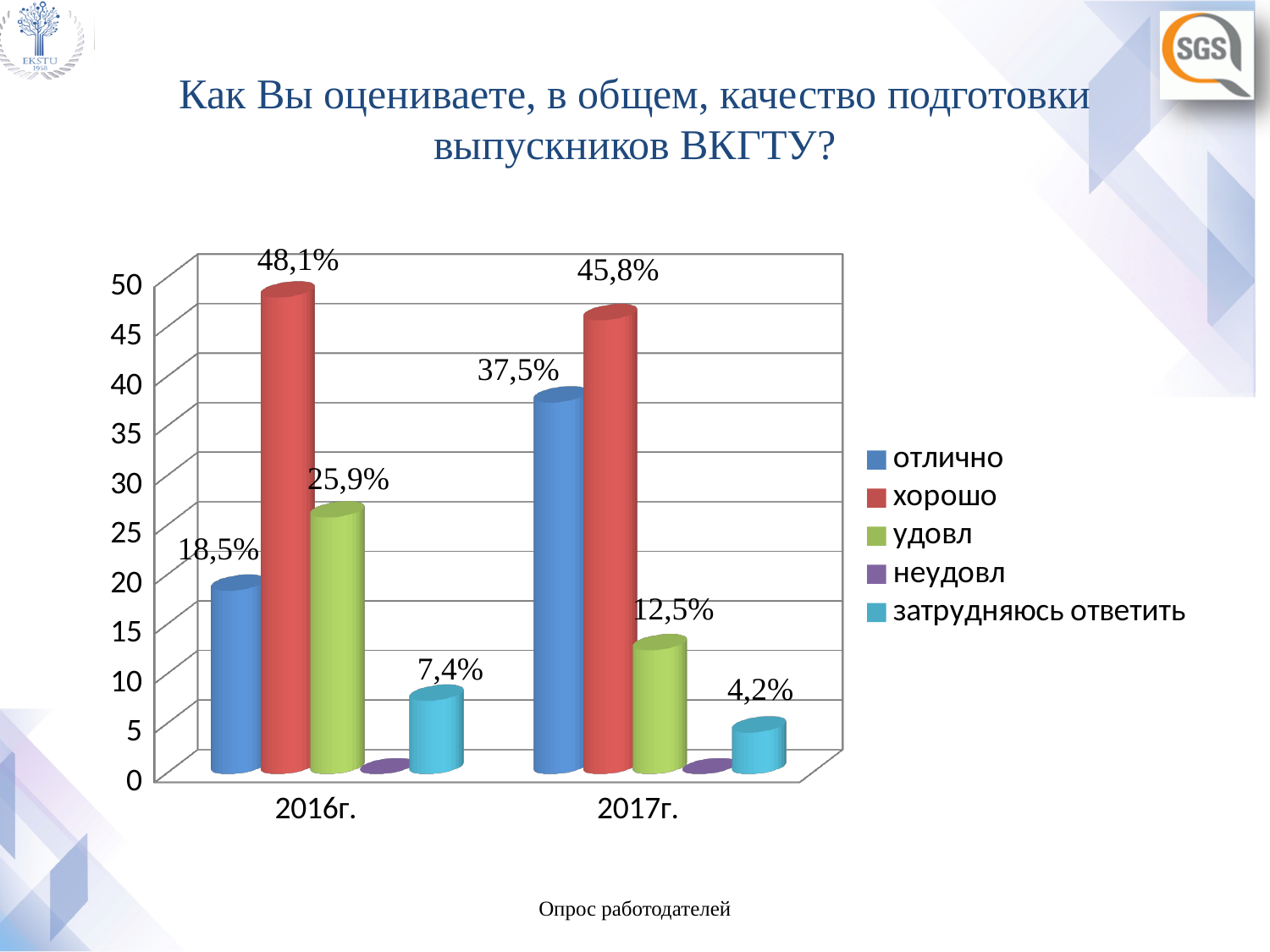
What is the difference between the "отлично" values for 2017г. and 2016г.? 19,0% How many series does the legend list? 5 What is the value for "удовл" in 2017г.? 12,5% Which series has the highest value in 2017г.? хорошо What is the value for "хорошо" in 2016г.? 48,1% Which is larger: "удовл" in 2016г. or "удовл" in 2017г.? 2016г. Is the value for "хорошо" in 2017г. greater or less than 40? greater What is the value for "отлично" in 2017г.? 37,5% How many categories are shown on the x axis? 2 Which labelled series has the lowest value in 2016г.? затрудняюсь ответить What is the value for "затрудняюсь ответить" in 2016г.? 7,4% What kind of chart is shown on the slide? bar chart